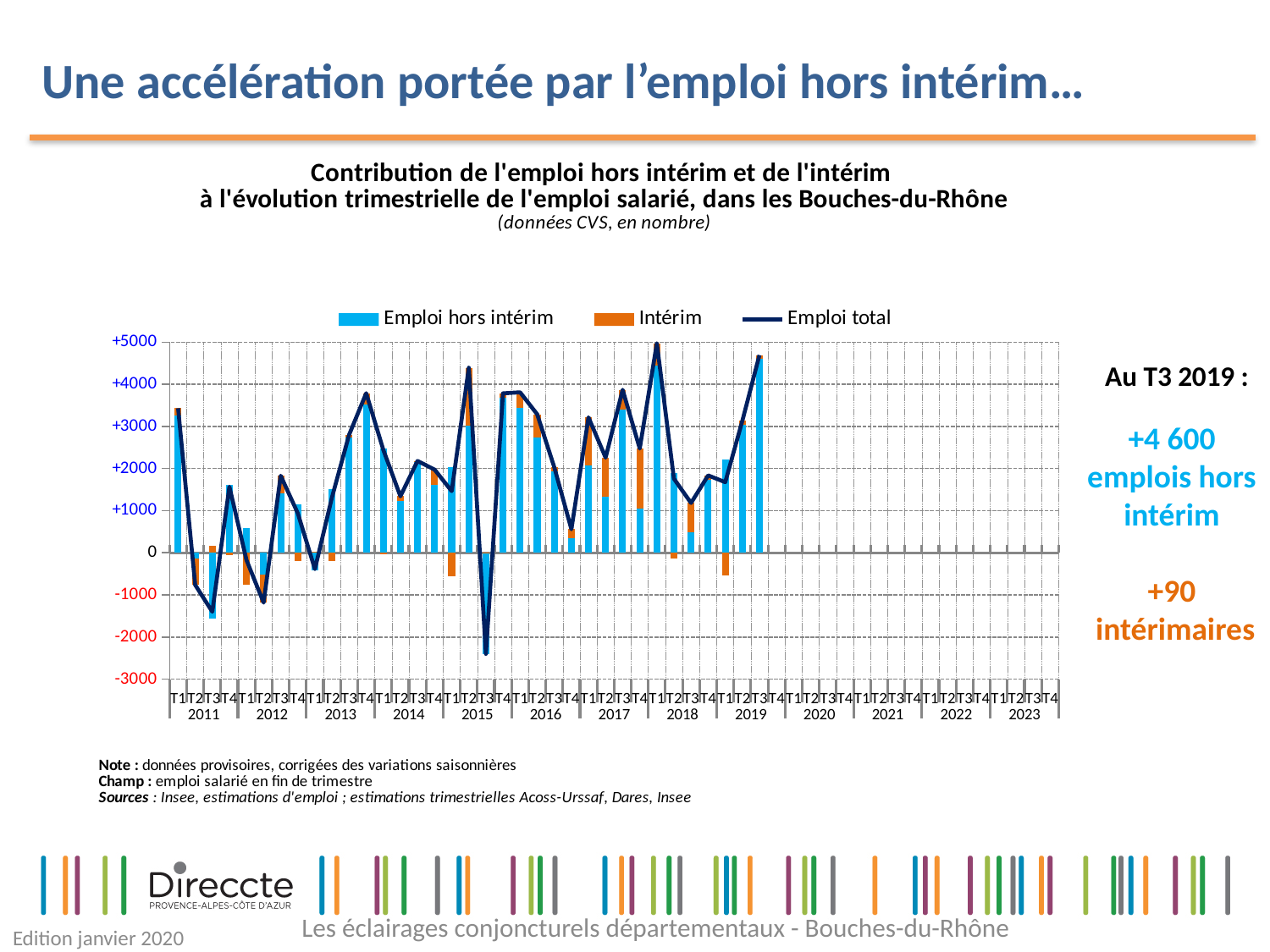
Is the value of Emploi total at T3 2015 greater or less than -2000? less How many series does the legend list? 3 According to the slide, what is the value of Emploi hors intérim at T3 2019? +4 600 According to the slide, what is the value of Intérim at T3 2019? +90 Which colour represents the Intérim series in the chart? Orange What is the difference between Emploi hors intérim (+4 600) and Intérim (+90) at T3 2019? 4 510 In which quarter does the Emploi total line reach its lowest point? T3 2015 Is the value of Emploi hors intérim at T1 2011 greater or less than 3000? greater How many years are labeled on the x axis of the chart? 13 What kind of chart is shown on the slide? A combined bar and line chart At T3 2019, which is larger: Emploi hors intérim or Intérim? Emploi hors intérim In which quarter does the Emploi total line reach its highest point? T1 2018